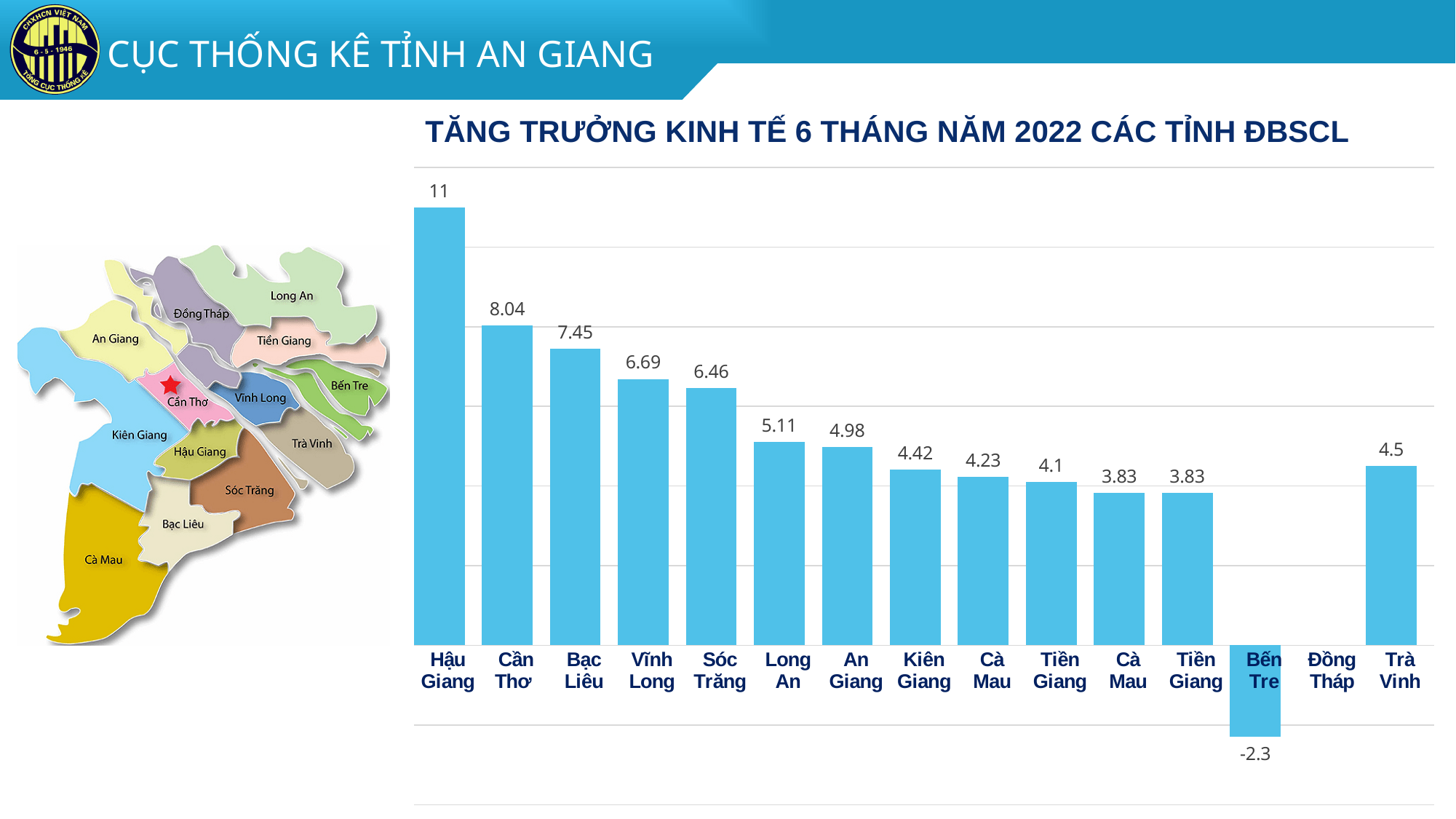
Which province has the lowest value? Bến Tre What is the value for Cần Thơ? 8.04 What is the value for Bến Tre? -2.3 What is the value for Trà Vinh? 4.5 What is the difference between the values for Hậu Giang and Cần Thơ? 2.96 Which province has the highest value? Hậu Giang What kind of chart is shown on the slide? Bar chart Which is larger, the value for Long An or the value for An Giang? Long An What is the value for Hậu Giang? 11 What is the value for An Giang? 4.98 What is the title of the chart? TĂNG TRƯỞNG KINH TẾ 6 THÁNG NĂM 2022 CÁC TỈNH ĐBSCL What is the difference between the values for Cần Thơ and Bạc Liêu? 0.59